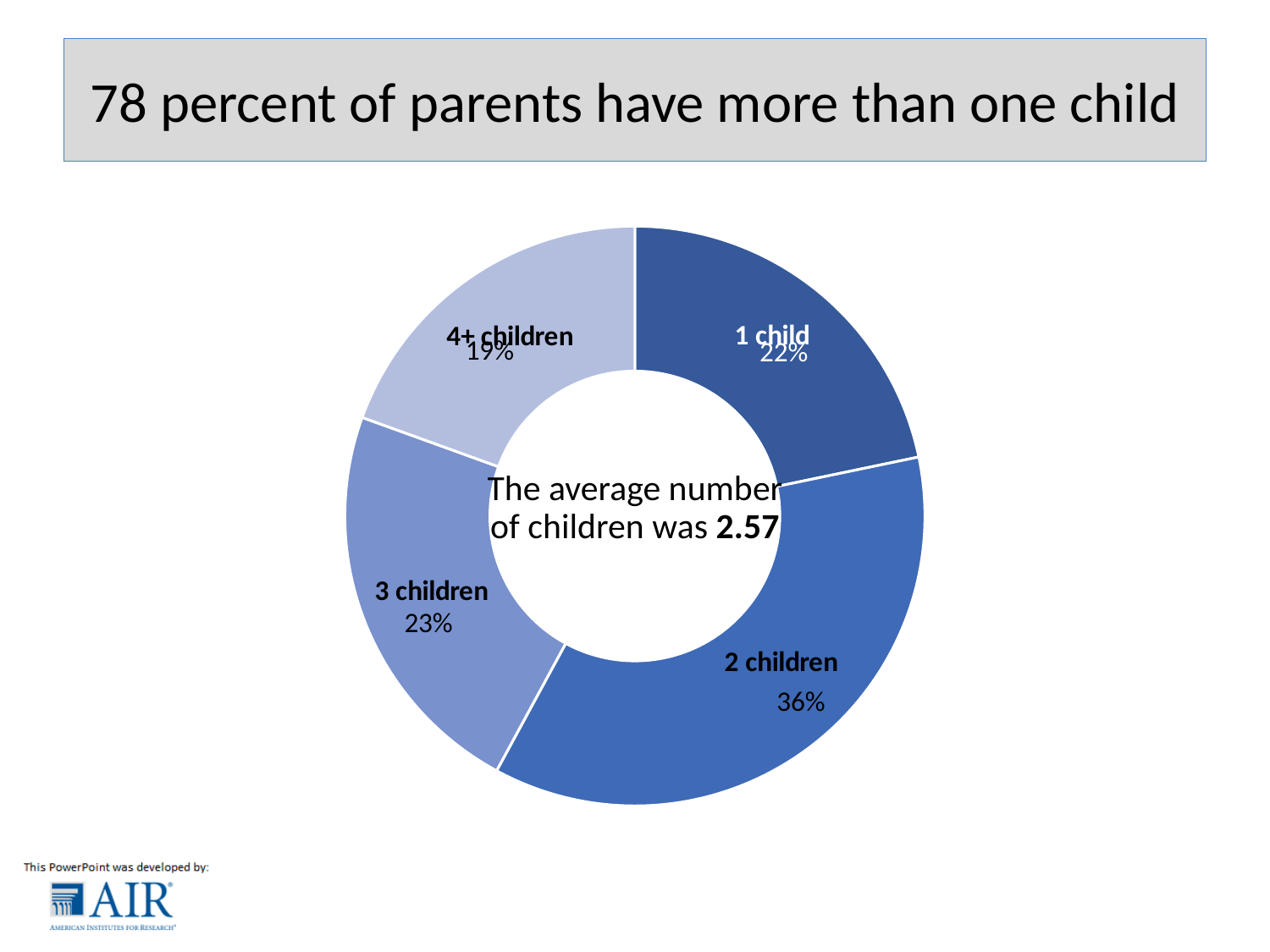
What kind of chart is shown on the slide? Doughnut (pie) chart What share of parents have 3 children? 23% Which is larger, the share for 2 children or the share for 3 children? 2 children How many categories does the chart show? 4 What share of parents have 1 child? 22% What is the difference in percentage points between the 2 children and 1 child shares? 14 What share of parents have 4+ children? 19% What average number of children is stated in the centre of the chart? 2.57 What share of parents have 2 children? 36% What is the combined share of parents with 3 children and 4+ children? 42% Which category has the largest share of the chart? 2 children Which category has the smallest share of the chart? 4+ children